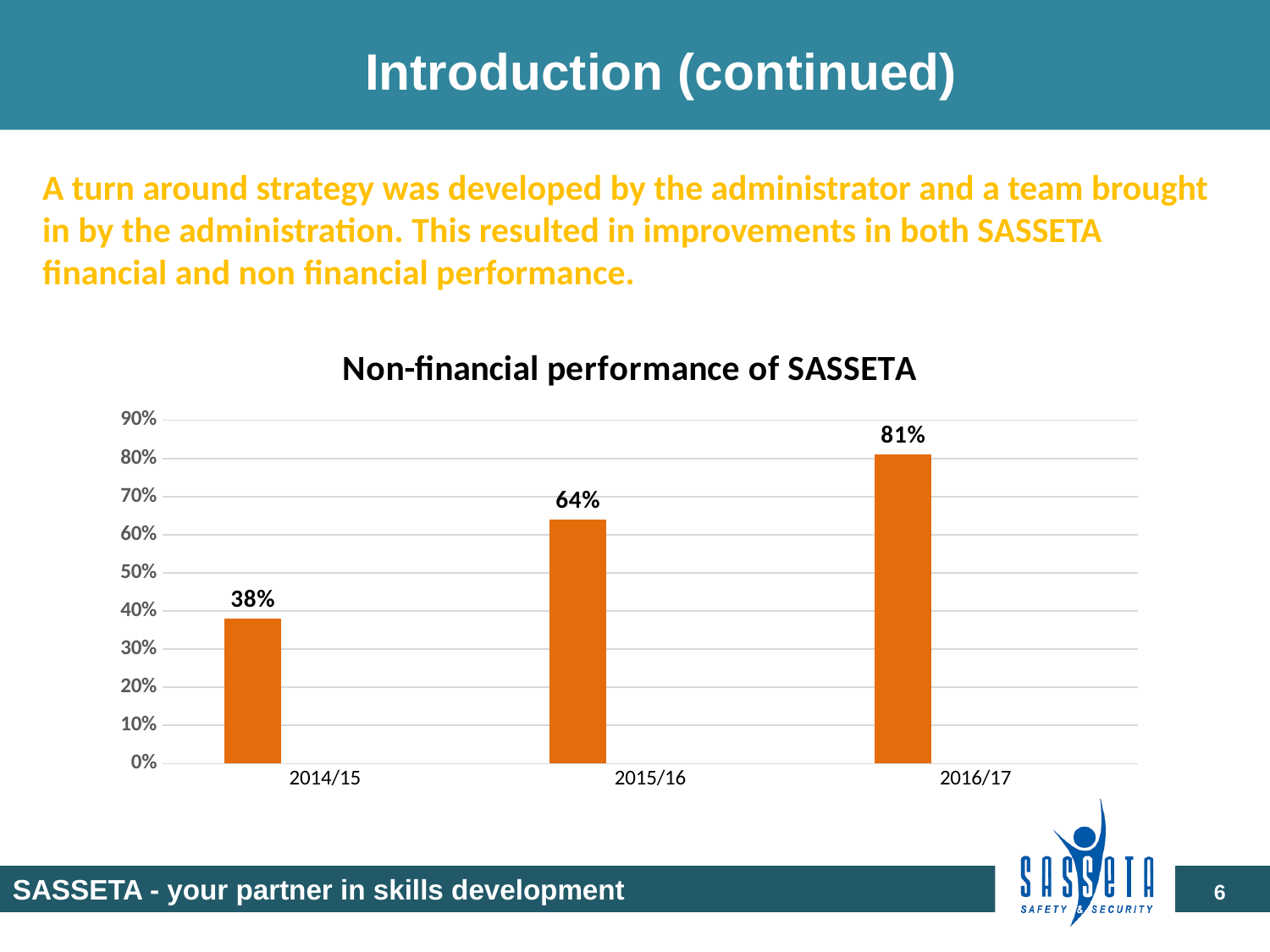
What is the difference between the 2016/17 and 2014/15 values? 43% What is the non-financial performance value for 2015/16? 64% What is the non-financial performance value for 2014/15? 38% What is the non-financial performance value for 2016/17? 81% Do the values rise or fall from 2014/15 to 2016/17? Rise Is the value for 2015/16 greater or less than 50%? greater Which year has the highest non-financial performance? 2016/17 How many years are shown on the chart? 3 What kind of chart is shown on the slide? Bar chart What is the difference between the 2015/16 and 2014/15 values? 26% Which year has the lowest non-financial performance? 2014/15 Which is larger, the value for 2015/16 or the value for 2016/17? 2016/17